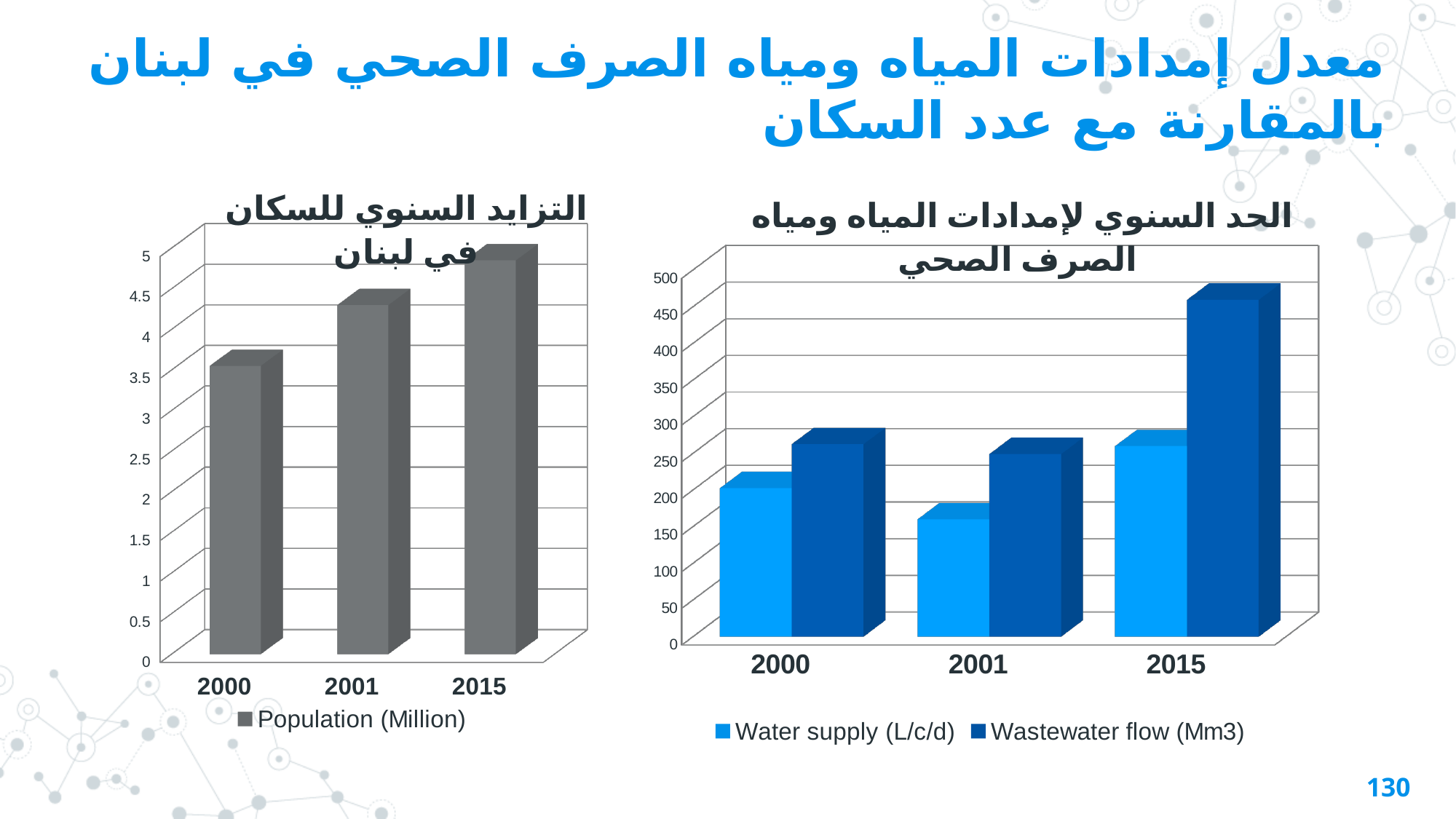
In the left chart (population), is the value for 2001 greater or less than 4? greater In the left chart (population), is the value for 2015 greater or less than 4.5? greater In the right chart (water supply and wastewater), which year has the highest Wastewater flow (Mm3) value? 2015 In the left chart (population), which year has the highest value? 2015 In the right chart (water supply and wastewater), for 2015, which is larger: Water supply (L/c/d) or Wastewater flow (Mm3)? Wastewater flow (Mm3) How many series does the legend of the right chart (water supply and wastewater) list? 2 In the right chart (water supply and wastewater), which year has the lowest Water supply (L/c/d) value? 2001 In the right chart (water supply and wastewater), is the Wastewater flow (Mm3) value for 2015 greater or less than 400? greater How many series does the legend of the left chart (population) list? 1 In the left chart (population), do the values rise or fall from 2000 to 2015? rise What kind of chart is the left chart (population)? bar chart How many years are shown on the x axis of the left chart (population)? 3